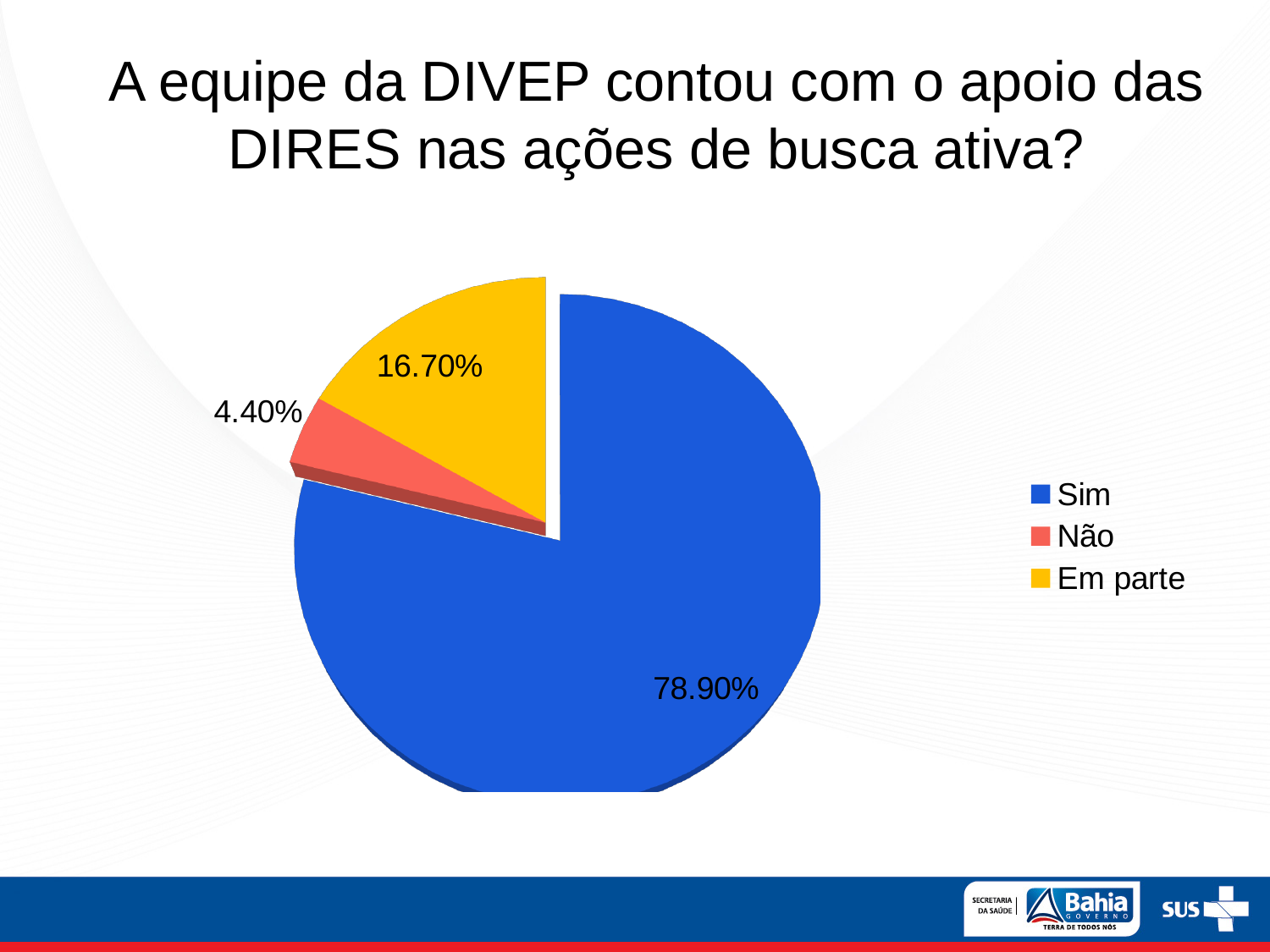
Which category has the smallest slice of the pie? Não Which is larger, the slice for "Não" or the slice for "Em parte"? Em parte What share of the pie does "Sim" represent? 78.90% What is the difference in percentage points between "Sim" and "Em parte"? 62.20% How many entries does the legend list? 3 Which category has the largest slice of the pie? Sim What is the difference in percentage points between "Em parte" and "Não"? 12.30% What share of the pie does "Em parte" represent? 16.70% What share of the pie does "Não" represent? 4.40% How many slices does the pie chart have? 3 What kind of chart is shown on the slide? pie chart What colour is the slice for "Em parte"? yellow